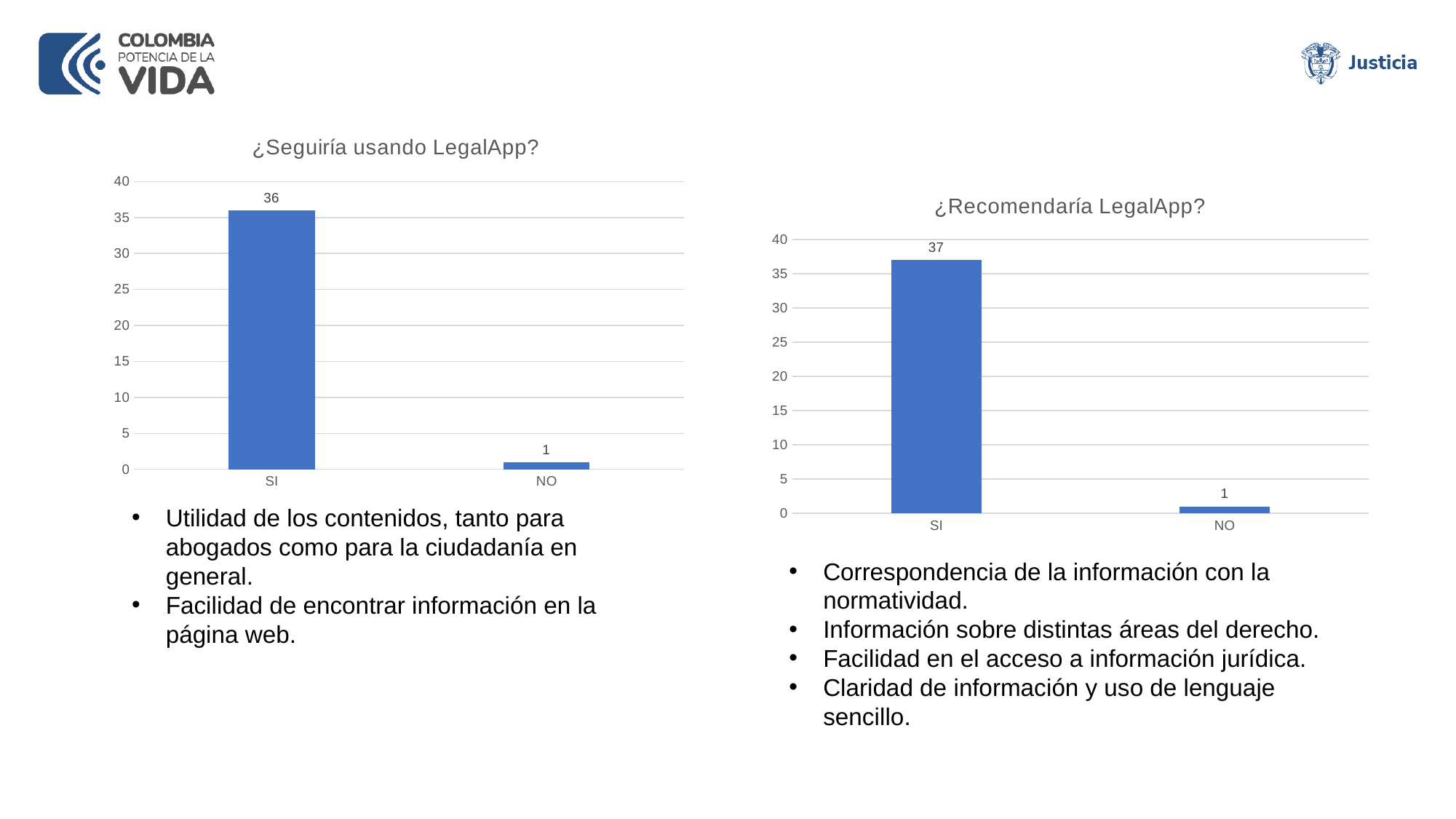
What kind of chart is the chart titled "¿Recomendaría LegalApp?"? Bar chart In the chart titled "¿Seguiría usando LegalApp?", what is the difference between the values for SI and NO? 35 In the chart titled "¿Recomendaría LegalApp?", what is the difference between the values for SI and NO? 36 In the chart titled "¿Recomendaría LegalApp?", what is the value for NO? 1 In the chart titled "¿Recomendaría LegalApp?", what is the value for SI? 37 In the chart titled "¿Seguiría usando LegalApp?", what is the value for SI? 36 What is the title of the chart on the left side of the slide? ¿Seguiría usando LegalApp? How many categories are shown in the chart titled "¿Seguiría usando LegalApp?"? 2 In the chart titled "¿Recomendaría LegalApp?", which category has the lowest value? NO In the chart titled "¿Recomendaría LegalApp?", is the value for SI greater or less than 35? greater In the chart titled "¿Seguiría usando LegalApp?", what is the value for NO? 1 In the chart titled "¿Seguiría usando LegalApp?", which category has the highest value? SI